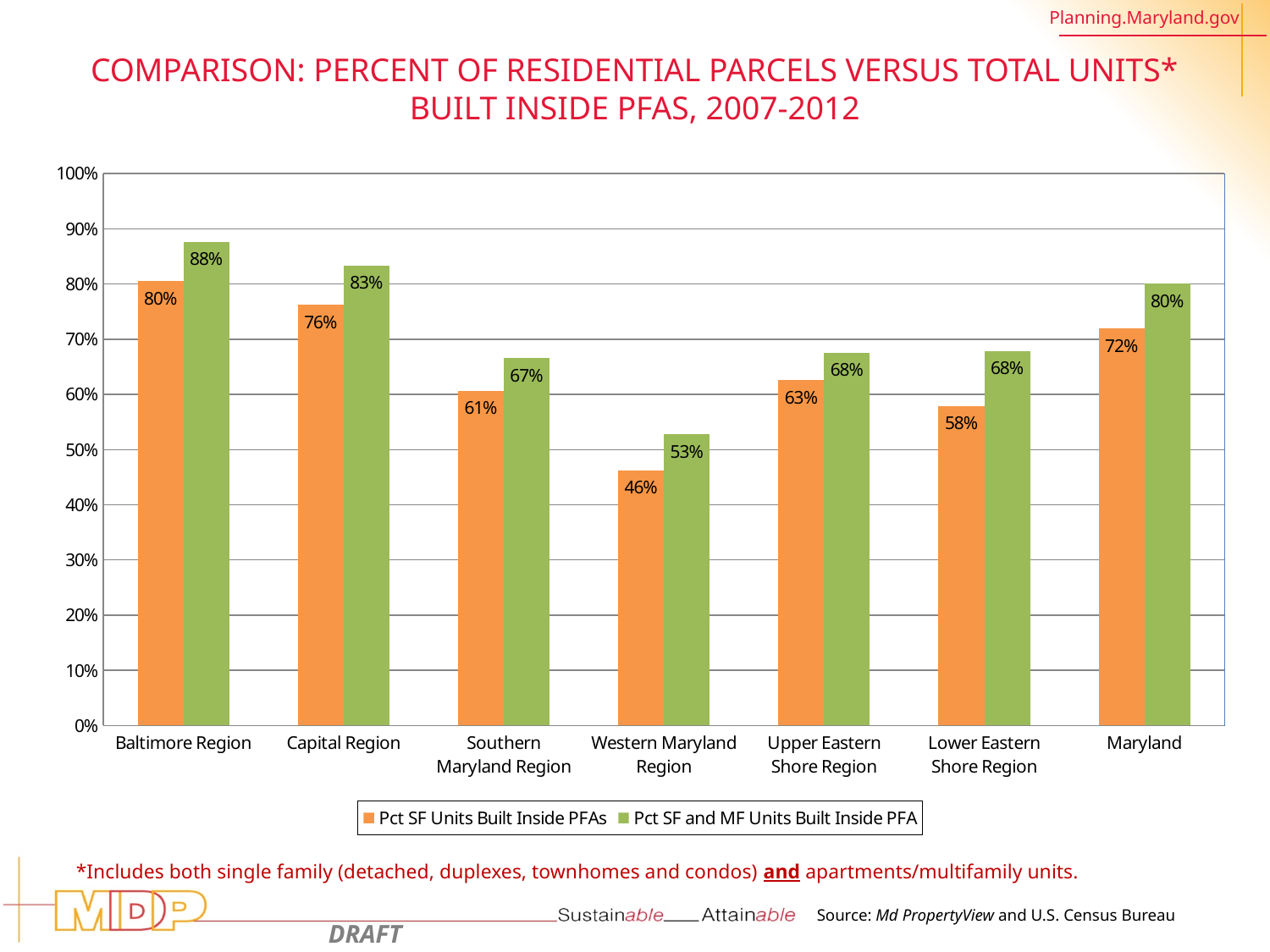
What is the difference between the Pct SF and MF Units Built Inside PFA and the Pct SF Units Built Inside PFAs for the Capital Region? 7% What is the value of Pct SF and MF Units Built Inside PFA for the Western Maryland Region? 53% Which is larger for Maryland: Pct SF Units Built Inside PFAs or Pct SF and MF Units Built Inside PFA? Pct SF and MF Units Built Inside PFA Is the value of Pct SF Units Built Inside PFAs for the Southern Maryland Region greater or less than 70%? less Which region has the highest value for Pct SF and MF Units Built Inside PFA? Baltimore Region Which colour represents Pct SF and MF Units Built Inside PFA in the chart? Green How many regions are shown on the x axis of the chart? 7 Which region has the lowest value for Pct SF Units Built Inside PFAs? Western Maryland Region What kind of chart is shown on the slide? Bar chart How many series does the legend list? 2 What is the value of Pct SF Units Built Inside PFAs for the Baltimore Region? 80% What is the value of Pct SF Units Built Inside PFAs for the Lower Eastern Shore Region? 58%